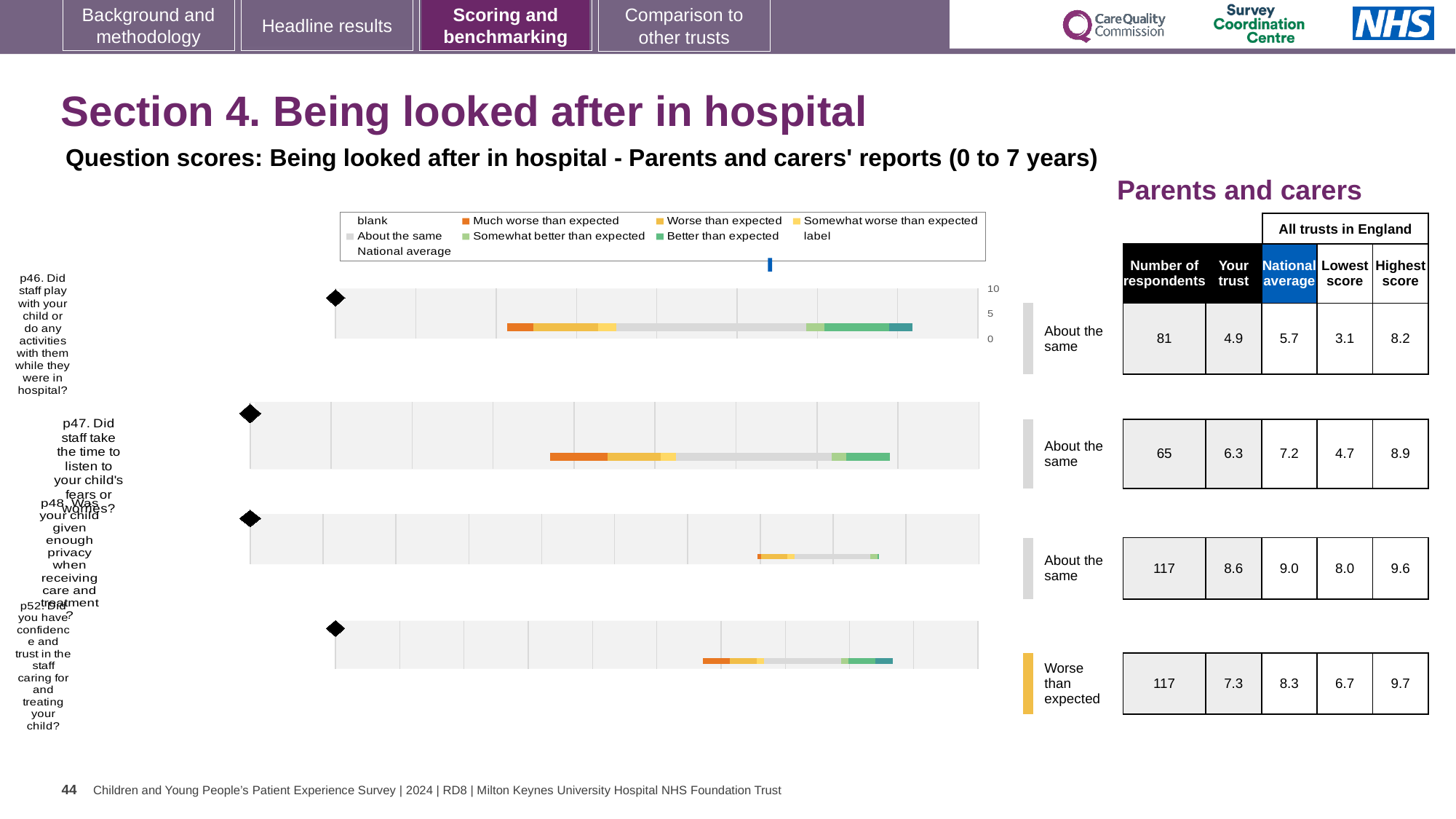
What kind of chart is used to show the score distribution for p46 (Did staff play with your child or do any activities with them while they were in hospital?)? bar chart How many question charts are shown on the slide? 4 In the table, how many respondents are recorded for p48 (Was your child given enough privacy when receiving care and treatment?)? 117 How many entries does the shared legend above the charts list? 9 In the table, what is the 'Your trust' score for p46 (Did staff play with your child or do any activities with them while they were in hospital?)? 4.9 For p46, what is the difference between the highest score and the lowest score across all trusts in England? 5.1 In the table, what is the highest score across all trusts in England for p52 (Did you have confidence and trust in the staff caring for and treating your child?)? 9.7 For p47, is the 'Your trust' score higher or lower than the national average? lower Which question has the highest 'Your trust' score in the table? p48 In the legend, what colour represents 'Better than expected'? green In the table, what is the national average for p47 (Did staff take the time to listen to your child's fears or worries?)? 7.2 In the legend, what colour represents 'Much worse than expected'? orange